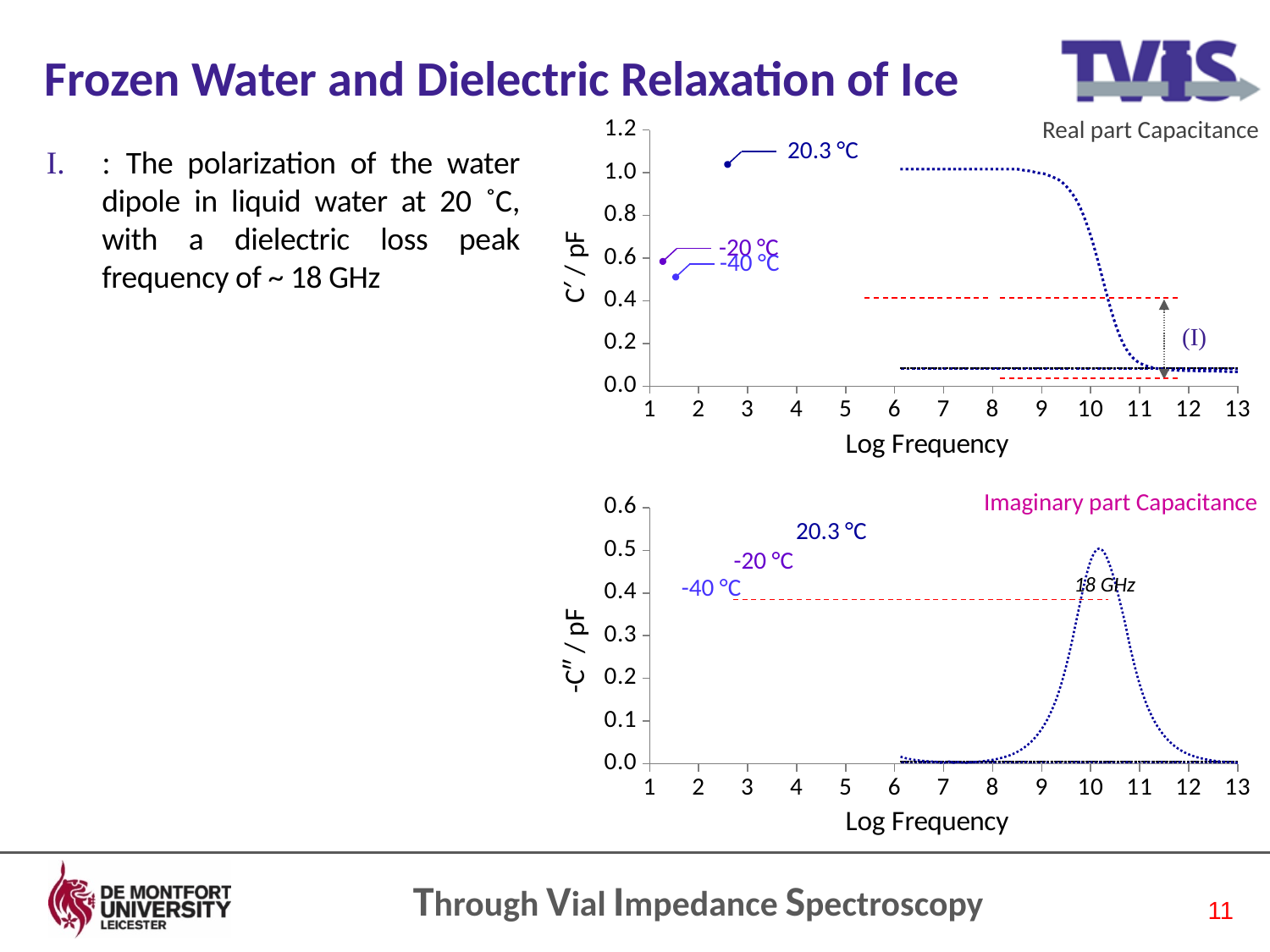
What is the x-axis label of the top chart (Real part Capacitance)? Log Frequency What is the highest tick value shown on the x-axis of the top chart (Real part Capacitance)? 13 In the bottom chart (Imaginary part Capacitance), is the peak value of the 20.3 °C curve greater or less than 0.4? greater In the top chart (Real part Capacitance), is the value of the 20.3 °C curve at log frequency 7 greater or less than 0.8? greater What kind of chart is the top chart titled "Real part Capacitance"? line chart In the bottom chart (Imaginary part Capacitance), is the value of the 20.3 °C curve at log frequency 7 greater or less than 0.1? less In the bottom chart (Imaginary part Capacitance), what frequency is annotated next to the peak of the curve? 18 GHz What is the highest tick value shown on the y-axis of the bottom chart (Imaginary part Capacitance)? 0.6 In the top chart (Real part Capacitance), does the 20.3 °C curve rise or fall as log frequency increases from 9 to 11? fall In the top chart (Real part Capacitance), how many temperature series are labelled? 3 What is the title of the bottom chart on the slide? Imaginary part Capacitance